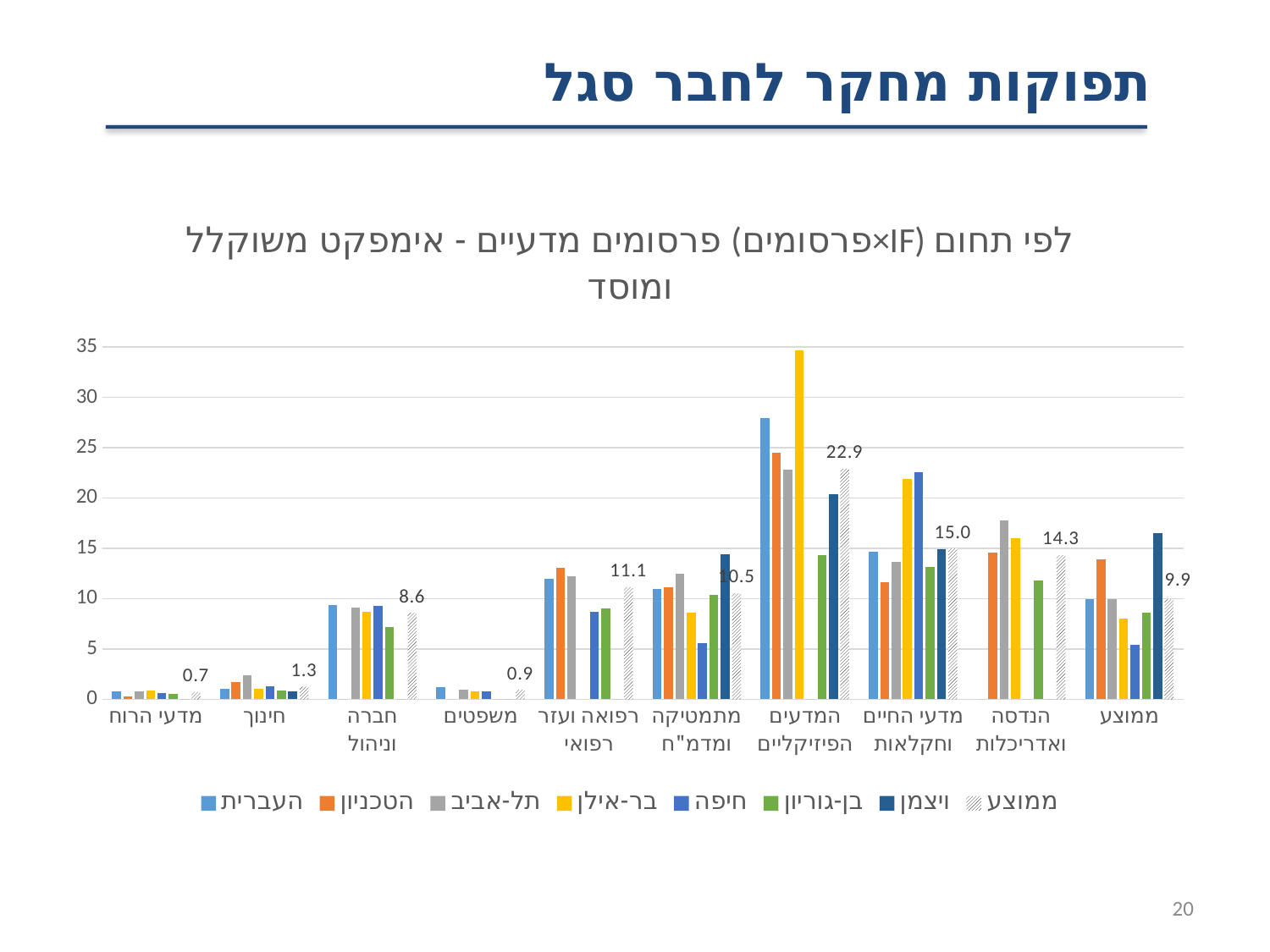
Is the value for העברית in המדעים הפיזיקליים greater or less than 25? greater What kind of chart is shown on the slide? Bar chart How many series does the legend list? 8 What is the difference between the ממוצע values for המדעים הפיזיקליים and מדעי החיים וחקלאות? 7.9 Among the labelled ממוצע values, which category has the lowest value? מדעי הרוח Which has the larger ממוצע value: חינוך or משפטים? חינוך What is the value of the ממוצע series for הנדסה ואדריכלות? 14.3 Is the value for בר-אילן in המדעים הפיזיקליים greater or less than 30? greater What is the value of the ממוצע (average) series for המדעים הפיזיקליים? 22.9 How many categories are shown on the x axis? 10 What is the value of the ממוצע series for מדעי הרוח? 0.7 Among the labelled ממוצע values, which category has the highest value? המדעים הפיזיקליים